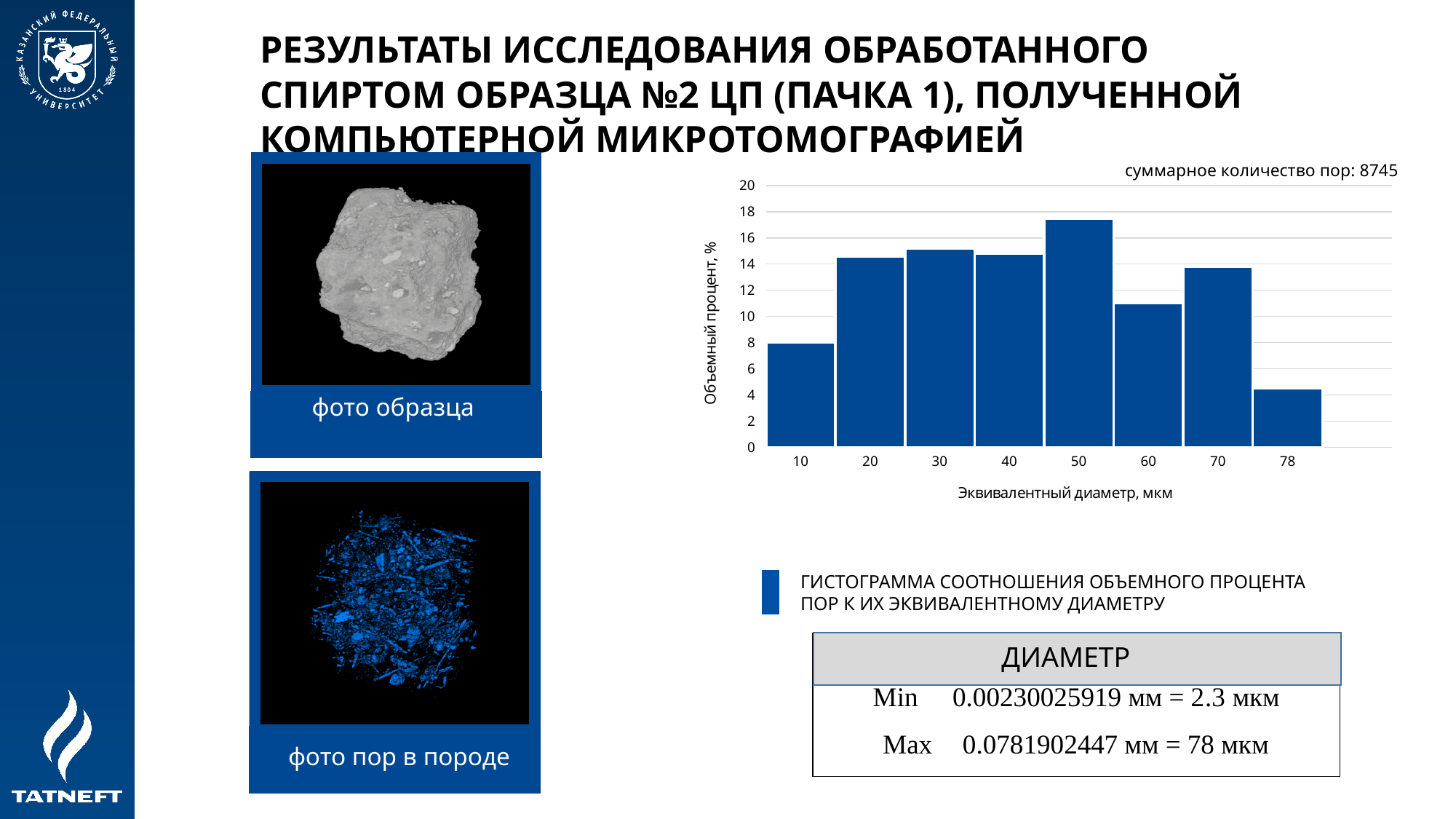
Which equivalent diameter category has the highest volume percent? 50 Is the volume percent for the 50 µm category greater or less than 16? greater Which has a larger volume percent: the 10 µm category or the 50 µm category? 50 How many bars (equivalent diameter categories) does the chart show? 8 What kind of chart is shown on the slide? bar chart Is the volume percent for the 30 µm category greater or less than 14? greater What is the label of the vertical axis of the chart? Объемный процент, % Which equivalent diameter category has the lowest volume percent? 78 Is the volume percent for the 60 µm category greater or less than 12? less What total number of pores is stated above the chart? 8745 Which has a larger volume percent: the 60 µm category or the 70 µm category? 70